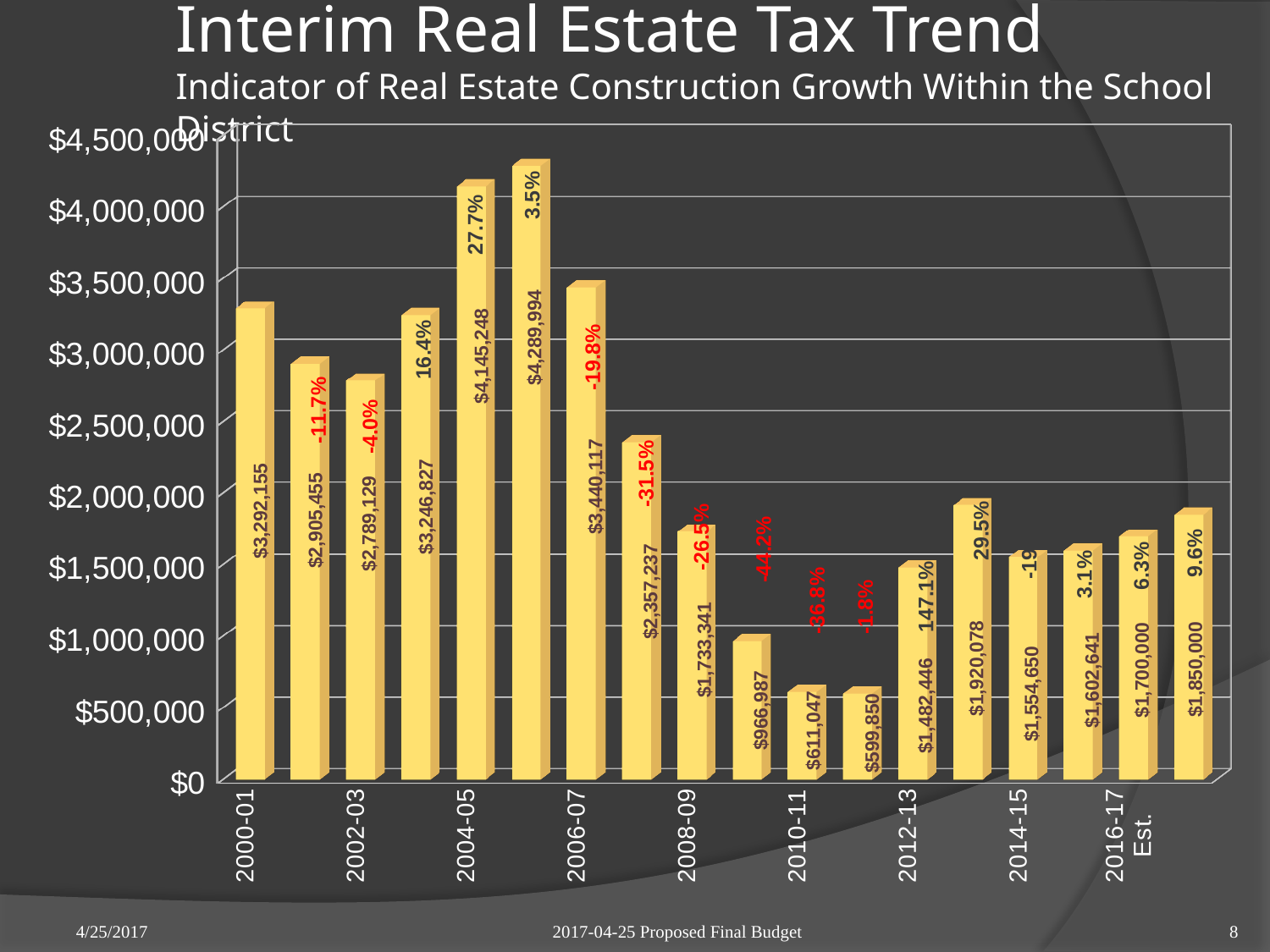
What is the estimated value shown for 2016-17 Est.? $1,700,000 How much larger is the value for 2004-05 than the value for 2000-01? $853,093 What is the interim real estate tax value for 2000-01? $3,292,155 Which is larger, the value for 2012-13 or the value for 2014-15? 2014-15 What is the value of the shortest bar in the chart? $599,850 How many bars are plotted in the chart? 18 What percentage change is printed on the bar for 2004-05? 27.7% What is the value shown for 2010-11? $611,047 Is the value for 2006-07 greater or less than $3,000,000? greater What is the value shown for 2004-05? $4,145,248 What is the value of the tallest bar in the chart? $4,289,994 What kind of chart is shown on the slide? bar chart